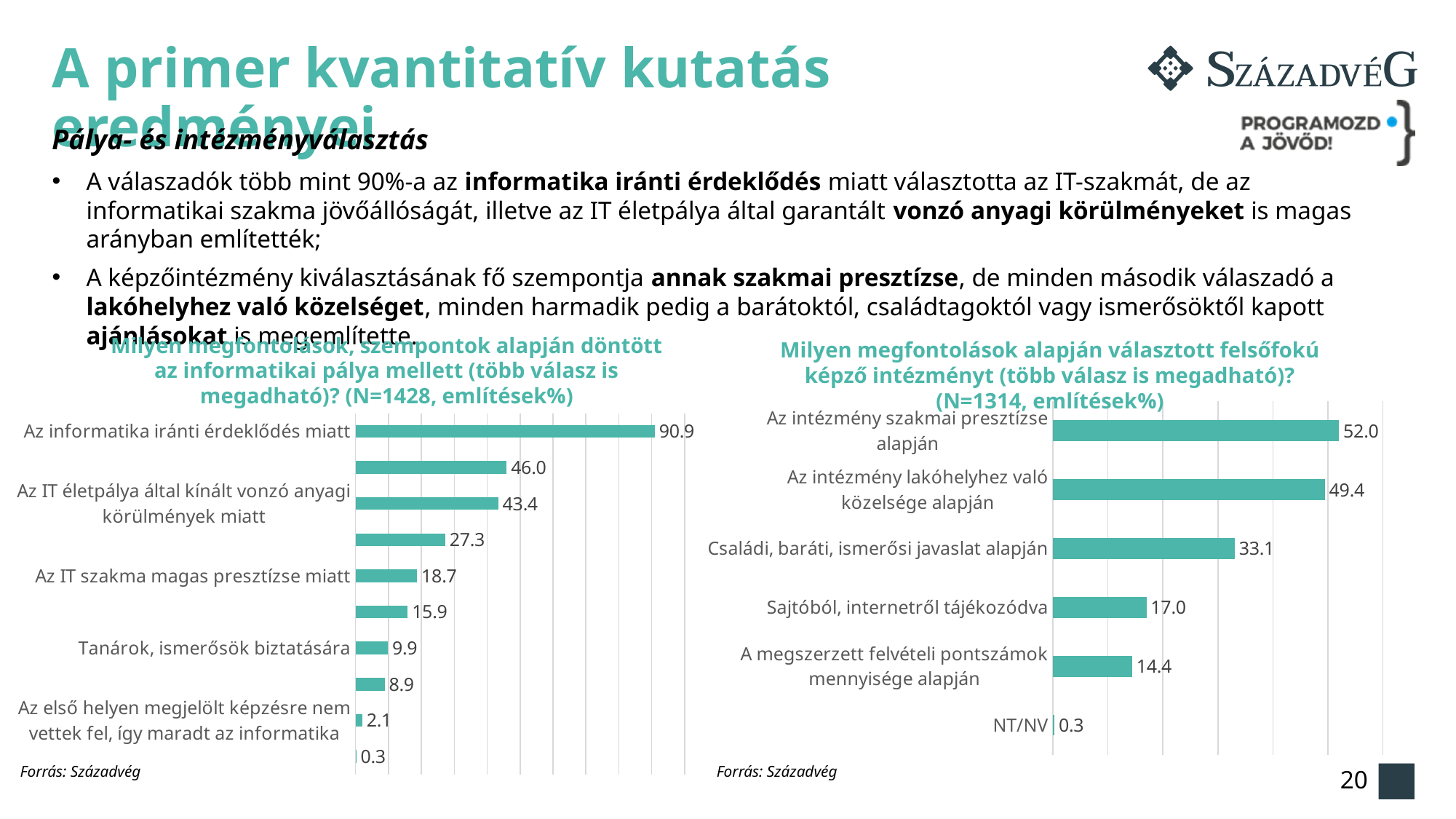
In the left chart (Milyen megfontolások, szempontok alapján döntött az informatikai pálya mellett), what is the value for 'Az informatika iránti érdeklődés miatt'? 90.9 In the left chart, what is the value for 'Tanárok, ismerősök biztatására'? 9.9 In the right chart, what is the value for 'Sajtóból, internetről tájékozódva'? 17.0 In the right chart, which category has the lowest value? NT/NV In the right chart, what is the difference between 'Az intézmény szakmai presztízse alapján' and 'Az intézmény lakóhelyhez való közelsége alapján'? 2.6 How many categories does the right chart show? 6 In the right chart, what is the value for 'Családi, baráti, ismerősi javaslat alapján'? 33.1 What type of chart is the left chart? Bar chart In the left chart, what is the value for 'Az IT szakma magas presztízse miatt'? 18.7 In the right chart, which is larger: 'Sajtóból, internetről tájékozódva' or 'A megszerzett felvételi pontszámok mennyisége alapján'? Sajtóból, internetről tájékozódva In the right chart (Milyen megfontolások alapján választott felsőfokú képző intézményt), what is the value for 'Az intézmény szakmai presztízse alapján'? 52.0 How many bars does the left chart show? 10